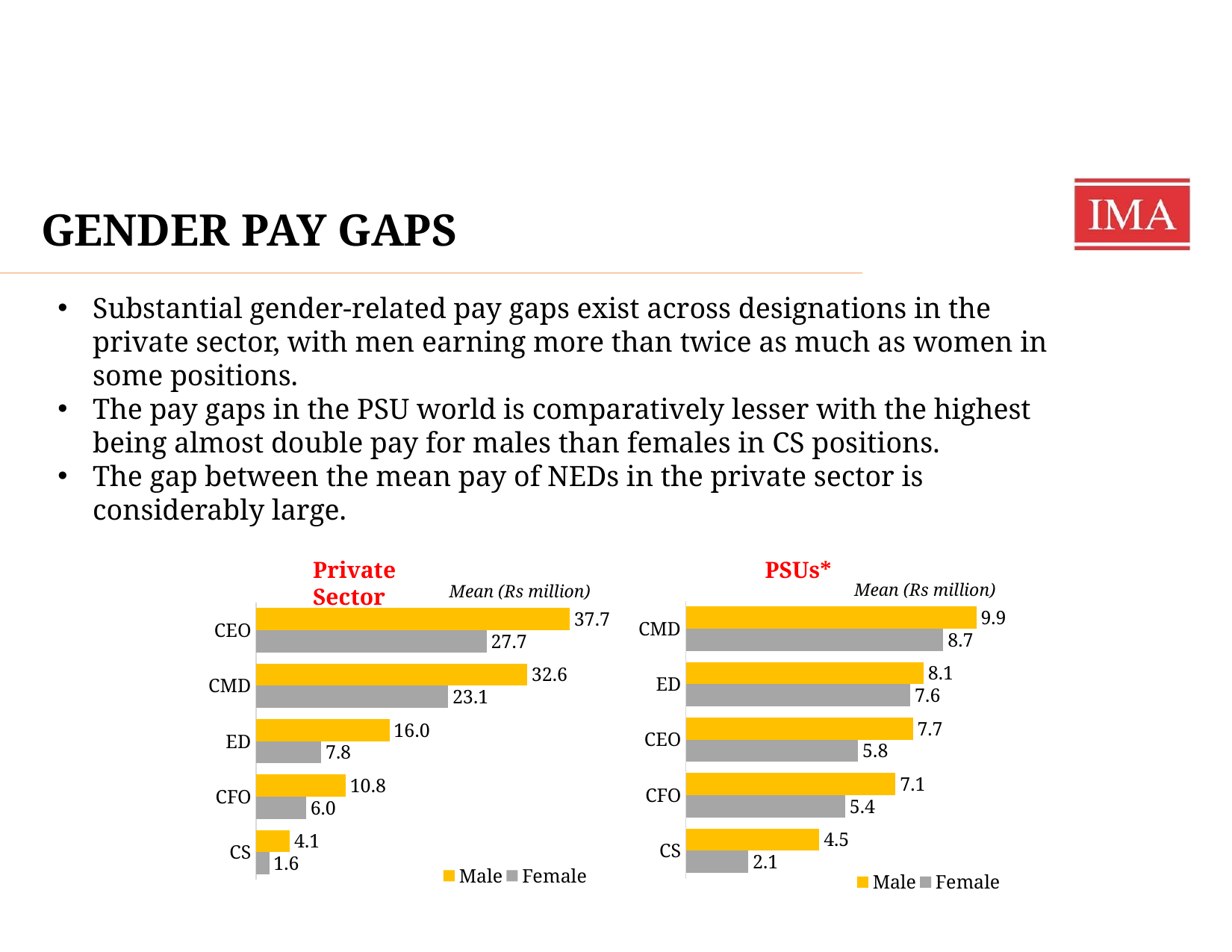
In the PSUs* chart, what is the mean pay for Male CS? 4.5 How many series does the legend of the Private Sector chart list? 2 In the Private Sector chart, which is larger: the Female mean pay for CEO or the Male mean pay for CMD? Male mean pay for CMD In the Private Sector chart, what is the mean pay for Male CEOs? 37.7 In the PSUs* chart, what is the difference between Male and Female mean pay for CEOs? 1.9 In the PSUs* chart, what is the mean pay for Female EDs? 7.6 In the PSUs* chart, which designation has the highest Male mean pay? CMD What type of chart is the Private Sector chart? Bar chart In the Private Sector chart, what is the difference between Male and Female mean pay for EDs? 8.2 In the Private Sector chart, which designation has the lowest Female mean pay? CS In the Private Sector chart, what is the mean pay for Female CMDs? 23.1 How many designations are shown in the PSUs* chart? 5